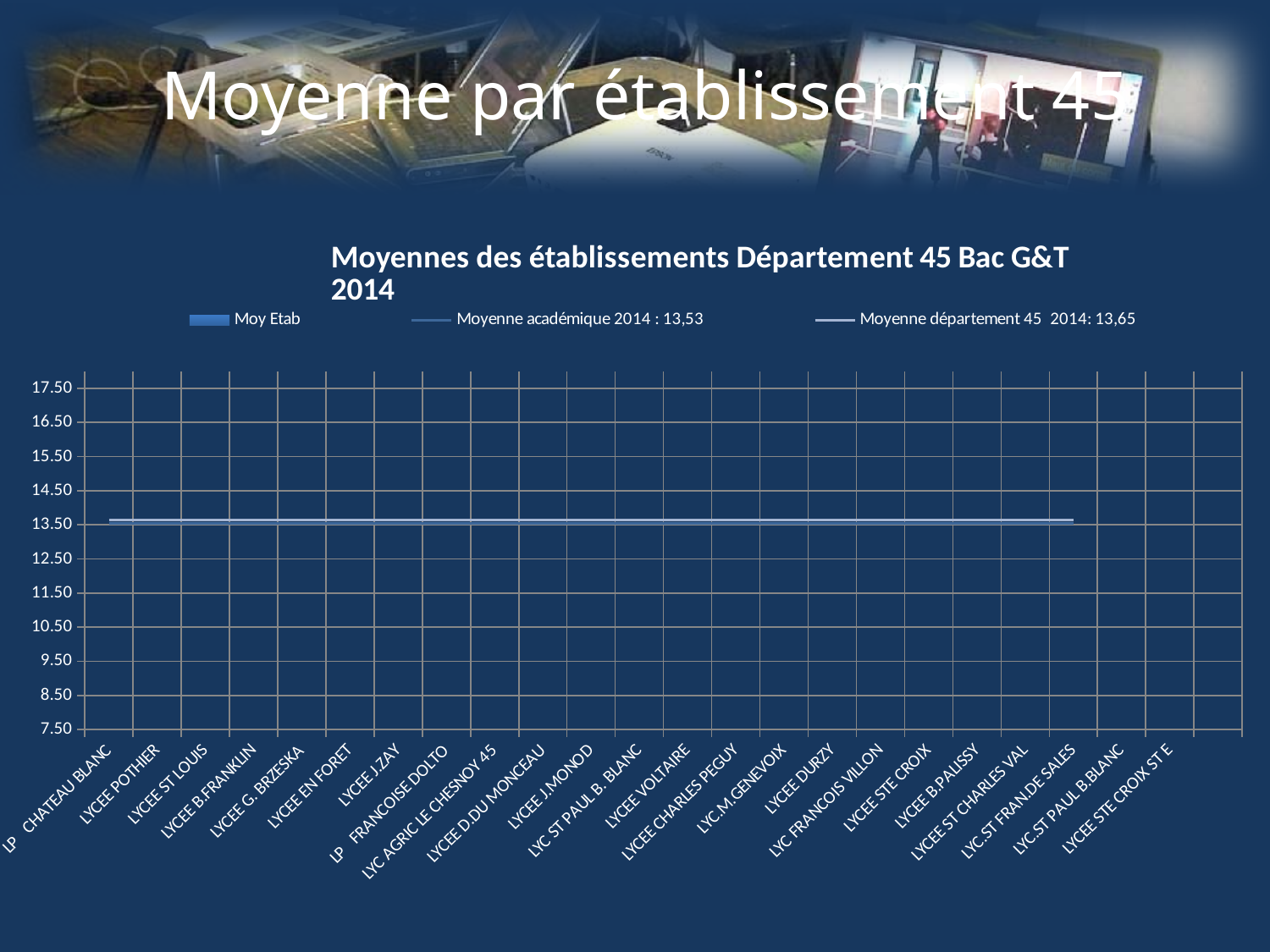
What is the name of the first series in the legend? Moy Etab What is the difference between the Moyenne département 45 2014 and the Moyenne académique 2014? 0,12 How many establishments are listed along the x axis? 23 What is the lowest value shown on the y axis? 7.50 Is the Moyenne académique 2014 line greater or less than 12.50? greater Is the Moyenne département 45 2014 line greater or less than 14.50? less What is the value of the Moyenne département 45 2014 shown in the legend? 13,65 What is the title of the chart? Moyennes des établissements Département 45 Bac G&T 2014 What is the highest value shown on the y axis? 17.50 How many series does the legend list? 3 Which is larger, the Moyenne académique 2014 or the Moyenne département 45 2014? Moyenne département 45 2014 What is the value of the Moyenne académique 2014 shown in the legend? 13,53